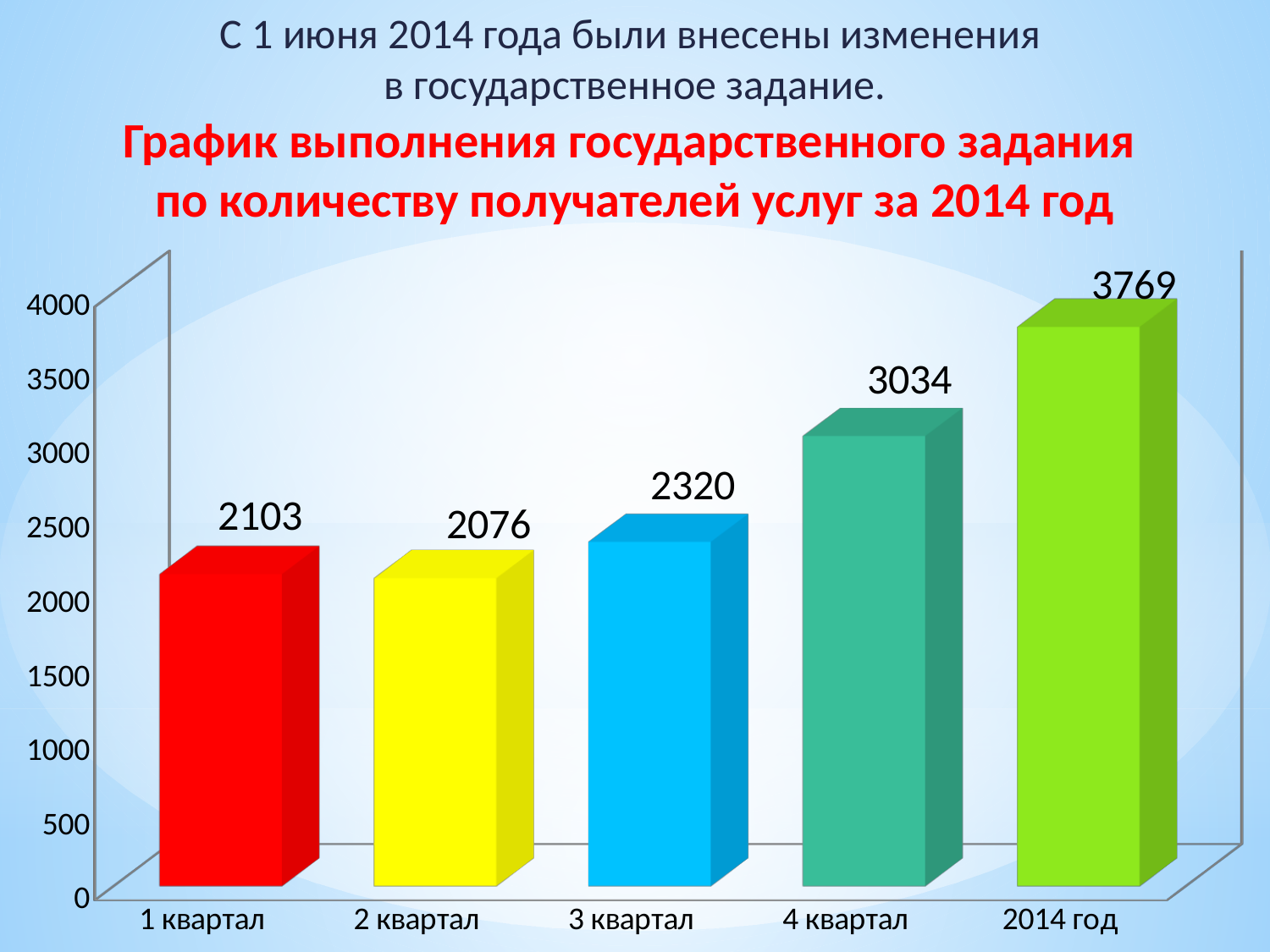
Is the value for 4 квартал greater or less than 3000? greater What is the difference between the values for 4 квартал and 3 квартал? 714 What is the value for 1 квартал? 2103 What is the value for 3 квартал? 2320 What is the value for 2014 год? 3769 Which category has the lowest value? 2 квартал Which is larger, the value for 1 квартал or the value for 2 квартал? 1 квартал What kind of chart is shown on the slide? bar chart Which category has the highest value? 2014 год How many categories are shown on the x axis? 5 What is the value for 4 квартал? 3034 What is the value for 2 квартал? 2076